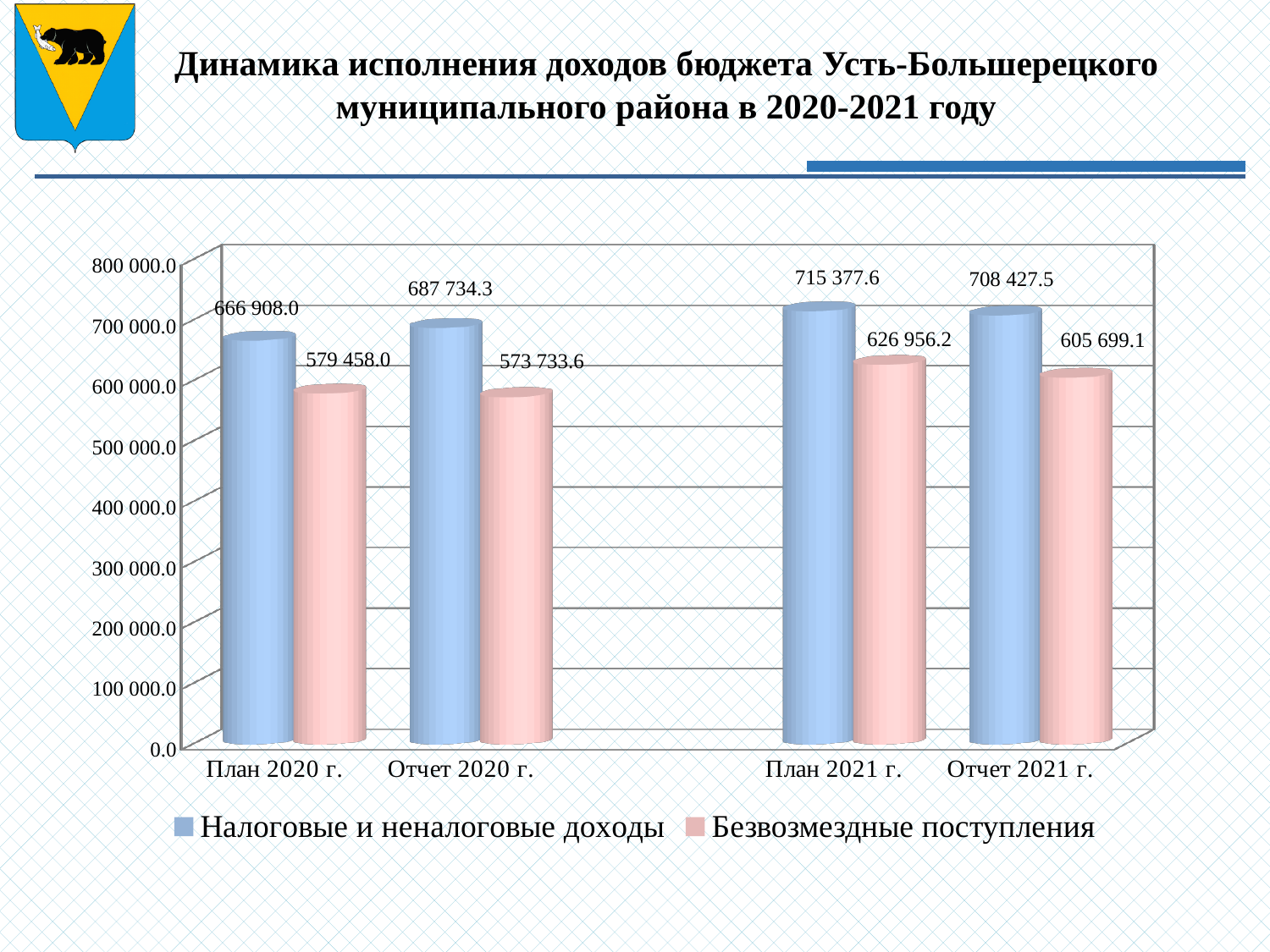
Is the value of Безвозмездные поступления for Отчет 2020 г. greater or less than 600 000.0? less What is the difference between Налоговые и неналоговые доходы for Отчет 2020 г. and План 2020 г.? 20 826.3 In which category is Безвозмездные поступления lowest? Отчет 2020 г. How many series does the legend list? 2 How many categories are shown on the x axis? 4 In which category is Налоговые и неналоговые доходы highest? План 2021 г. What is the value of Налоговые и неналоговые доходы for План 2020 г.? 666 908.0 What is the value of Налоговые и неналоговые доходы for Отчет 2020 г.? 687 734.3 What is the difference between Безвозмездные поступления for План 2021 г. and Отчет 2021 г.? 21 257.1 Which is larger for План 2021 г.: Налоговые и неналоговые доходы or Безвозмездные поступления? Налоговые и неналоговые доходы What is the value of Безвозмездные поступления for Отчет 2021 г.? 605 699.1 What kind of chart is shown on the slide? bar chart